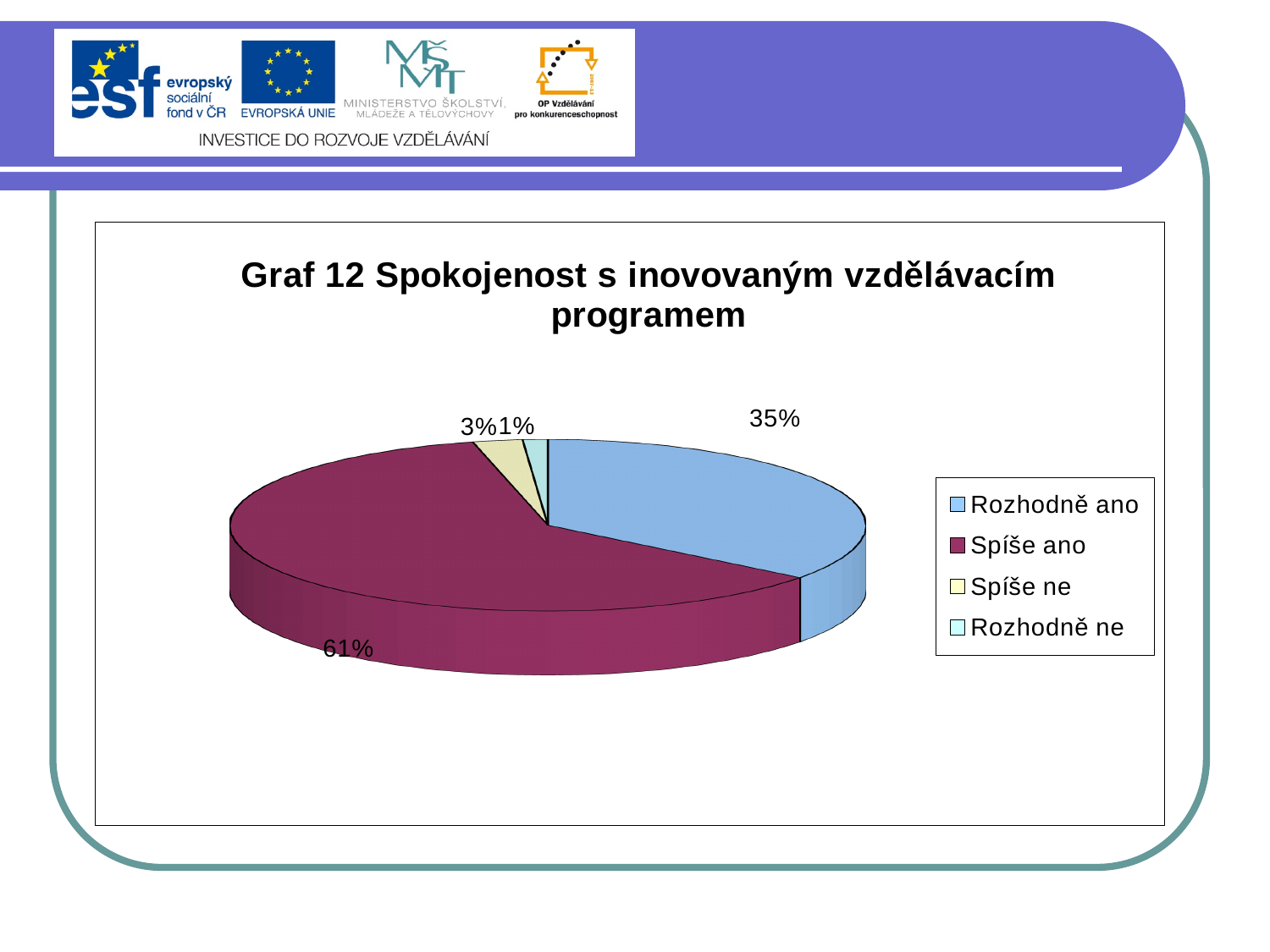
What is the difference in percentage points between "Spíše ano" and "Rozhodně ano"? 26 What colour is the slice for "Spíše ano"? Purple (magenta) How many categories does the pie chart show? 4 Which category has the smallest slice of the pie? Rozhodně ne What is the title of the chart? Graf 12 Spokojenost s inovovaným vzdělávacím programem What share of the pie does "Spíše ano" represent? 61% What share of the pie does "Rozhodně ano" represent? 35% What kind of chart is shown on the slide? Pie chart What share of the pie does "Spíše ne" represent? 3% Which category has the largest slice of the pie? Spíše ano Which is larger, the share for "Rozhodně ano" or the share for "Spíše ne"? Rozhodně ano